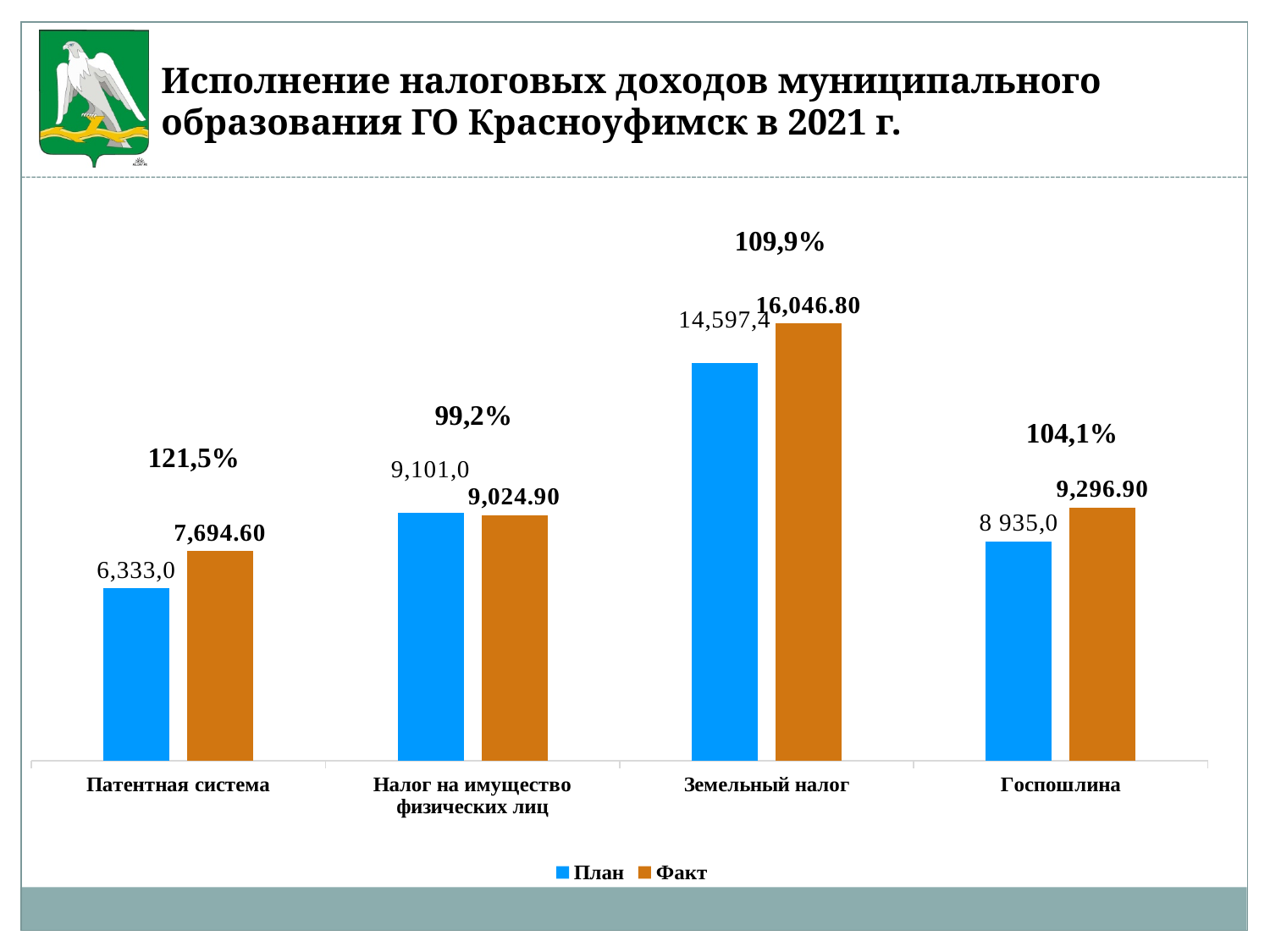
For Налог на имущество физических лиц, which is larger: План or Факт? План What is the Факт value for Госпошлина? 9,296.90 Which category has the lowest План value? Патентная система What is the difference between the Факт values for Земельный налог and Госпошлина? 6,749.90 What is the План value for Патентная система? 6,333,0 How many series does the legend list? 2 What percentage is shown above the bars for Патентная система? 121,5% Which series is shown in orange in the legend? Факт What is the Факт value for Земельный налог? 16,046.80 Which category has the highest Факт value? Земельный налог How many categories are shown on the x axis? 4 What type of chart is shown on the slide? Bar chart